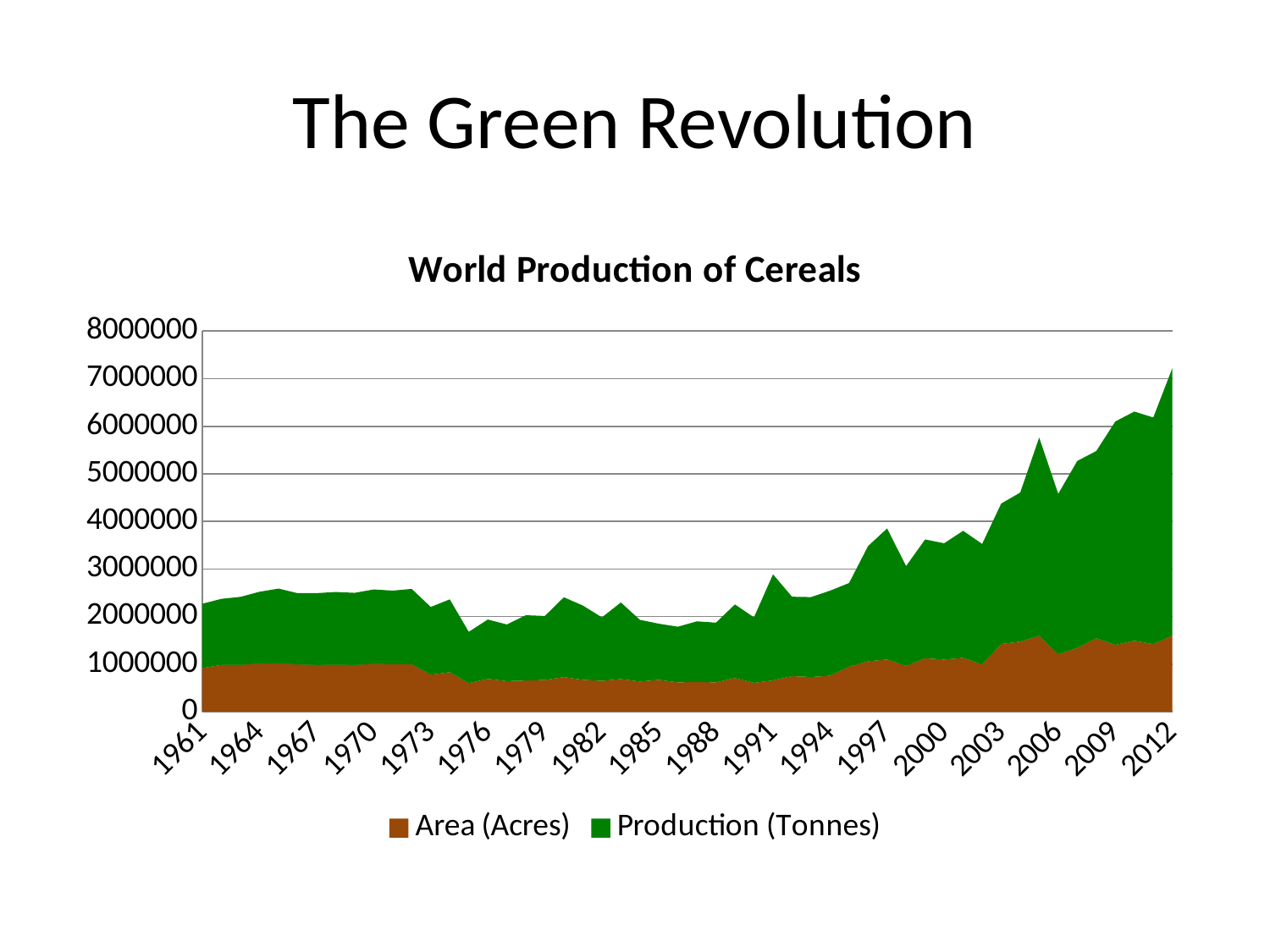
Which series is shown in green? Production (Tonnes) Is the stacked total for 2006 greater or less than 4000000? greater Which year has the highest stacked total? 2012 What kind of chart is shown on the slide? Stacked area chart Is the stacked total for 2012 greater or less than 6000000? greater How many year labels are shown on the x axis? 18 How many series does the legend list? 2 Is the value for Area (Acres) in 2012 greater or less than 1000000? greater Which is larger, the stacked total in 1961 or in 2012? 2012 Does the stacked total generally rise or fall from 1991 to 2012? rise What is the title of the chart? World Production of Cereals